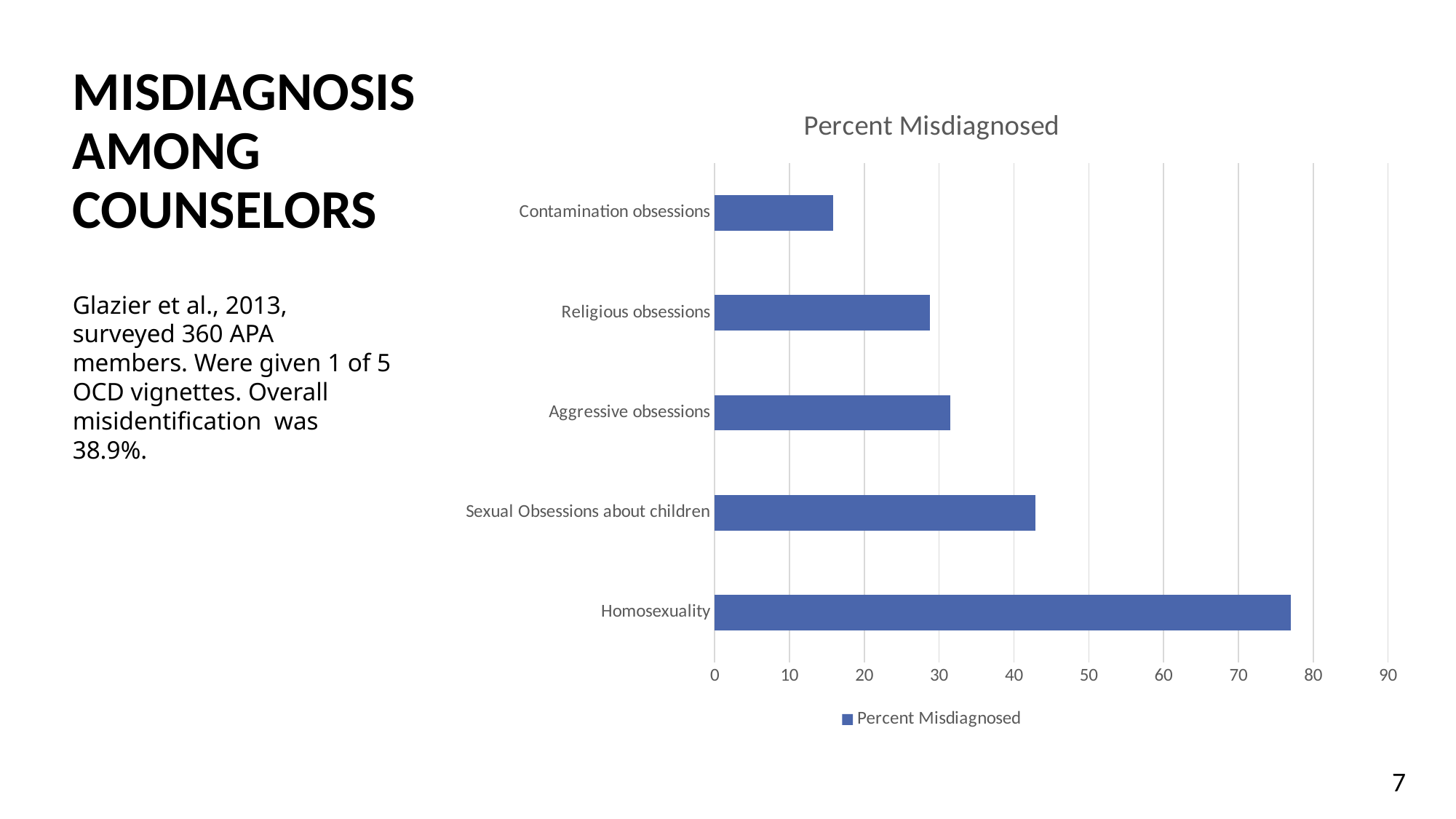
Is the value for Contamination obsessions greater or less than 20? less Is the value for Homosexuality greater or less than 70? greater What is the legend entry shown below the chart? Percent Misdiagnosed What kind of chart is shown on the slide? bar chart Which category has the highest percent misdiagnosed? Homosexuality Which category has the lowest percent misdiagnosed? Contamination obsessions How many series does the legend list? 1 Is the value for Sexual Obsessions about children greater or less than 40? greater Which has a larger percent misdiagnosed, Sexual Obsessions about children or Aggressive obsessions? Sexual Obsessions about children How many categories are plotted in the chart? 5 What is the title of the chart? Percent Misdiagnosed